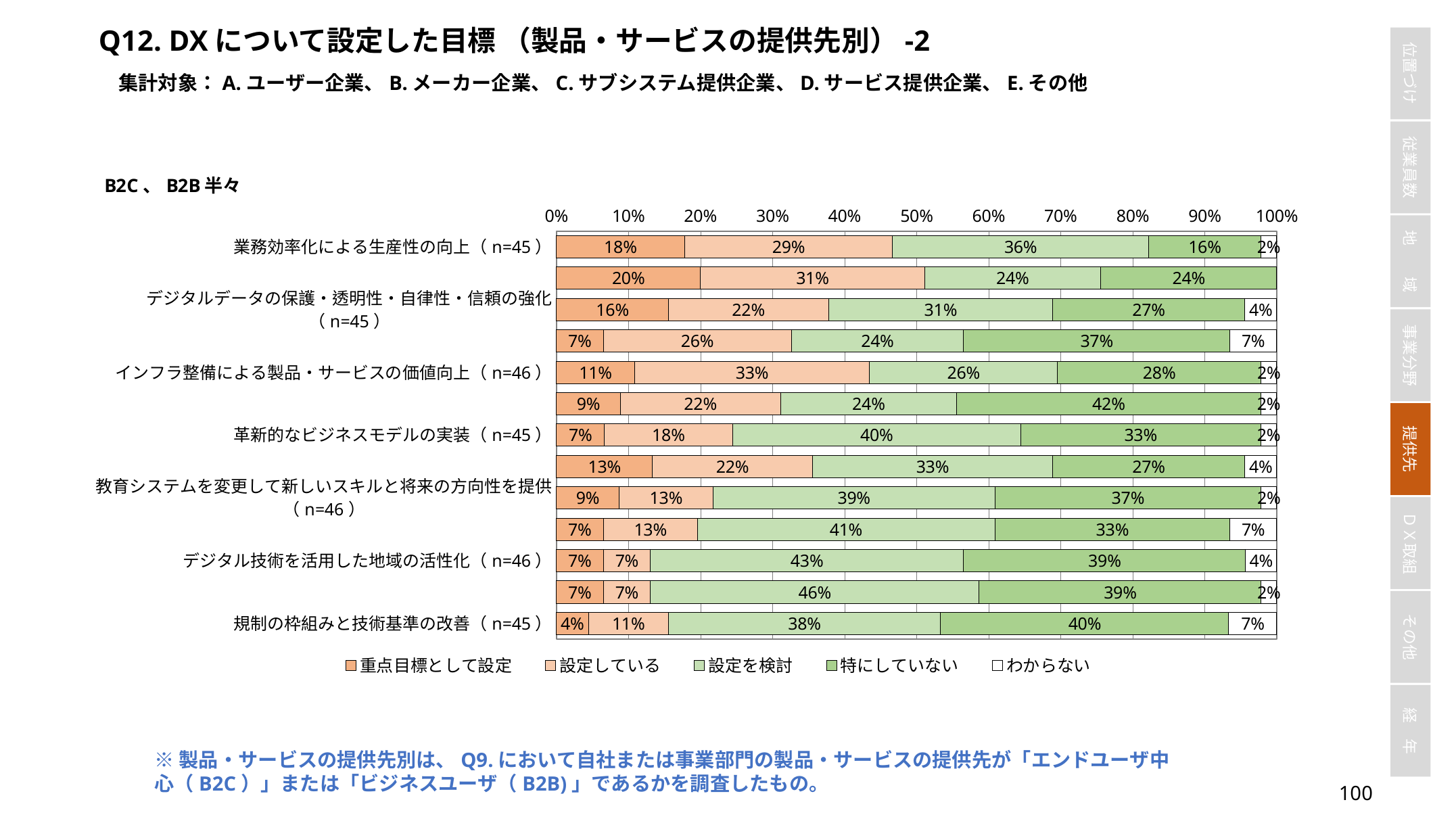
What is the value of わからない for 規制の枠組みと技術基準の改善（n=45）? 7% What is the value of 特にしていない for 規制の枠組みと技術基準の改善（n=45）? 40% Which series has the largest segment in the bar for 業務効率化による生産性の向上（n=45）? 設定を検討 What is the value of 重点目標として設定 for 業務効率化による生産性の向上（n=45）? 18% What is the value of 設定を検討 for 業務効率化による生産性の向上（n=45）? 36% How many series does the legend list? 5 For 規制の枠組みと技術基準の改善（n=45）, which is larger: 設定を検討 or 特にしていない? 特にしていない For 業務効率化による生産性の向上（n=45）, how much larger is 設定している than 重点目標として設定? 11 percentage points What is the first entry in the chart's legend? 重点目標として設定 What is the value of 設定を検討 for デジタル技術を活用した地域の活性化（n=46）? 43% What is the value of 設定を検討 for 革新的なビジネスモデルの実装（n=45）? 40% What kind of chart is shown on the slide? Stacked bar chart